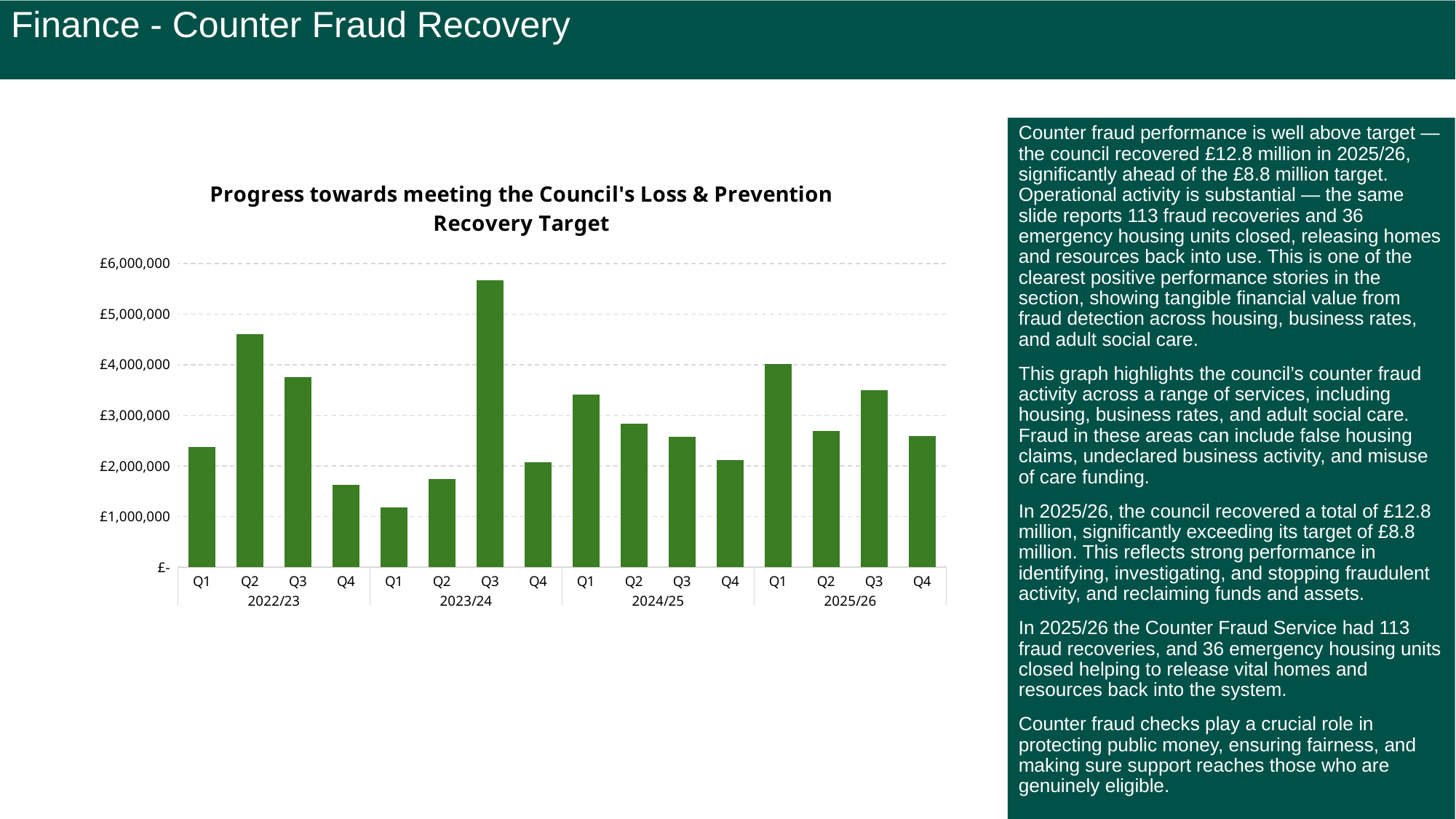
Which quarter has the highest recovery value in the chart? Q3 2023/24 Is the value for Q2 2022/23 greater or less than £4,000,000? greater Is the value for Q3 2023/24 greater or less than £5,000,000? greater Is the value for Q1 2025/26 greater or less than £3,000,000? greater Across the four quarters of 2024/25, do the values rise or fall from Q1 to Q4? Fall What is the title of the chart? Progress towards meeting the Council's Loss & Prevention Recovery Target Which is larger, the value for Q1 2025/26 or the value for Q2 2025/26? Q1 2025/26 How many bars (quarters) are plotted in the chart? 16 Which quarter has the lowest recovery value in the chart? Q1 2023/24 What kind of chart is shown on the slide? Bar chart Which is larger, the value for Q2 2022/23 or the value for Q3 2022/23? Q2 2022/23